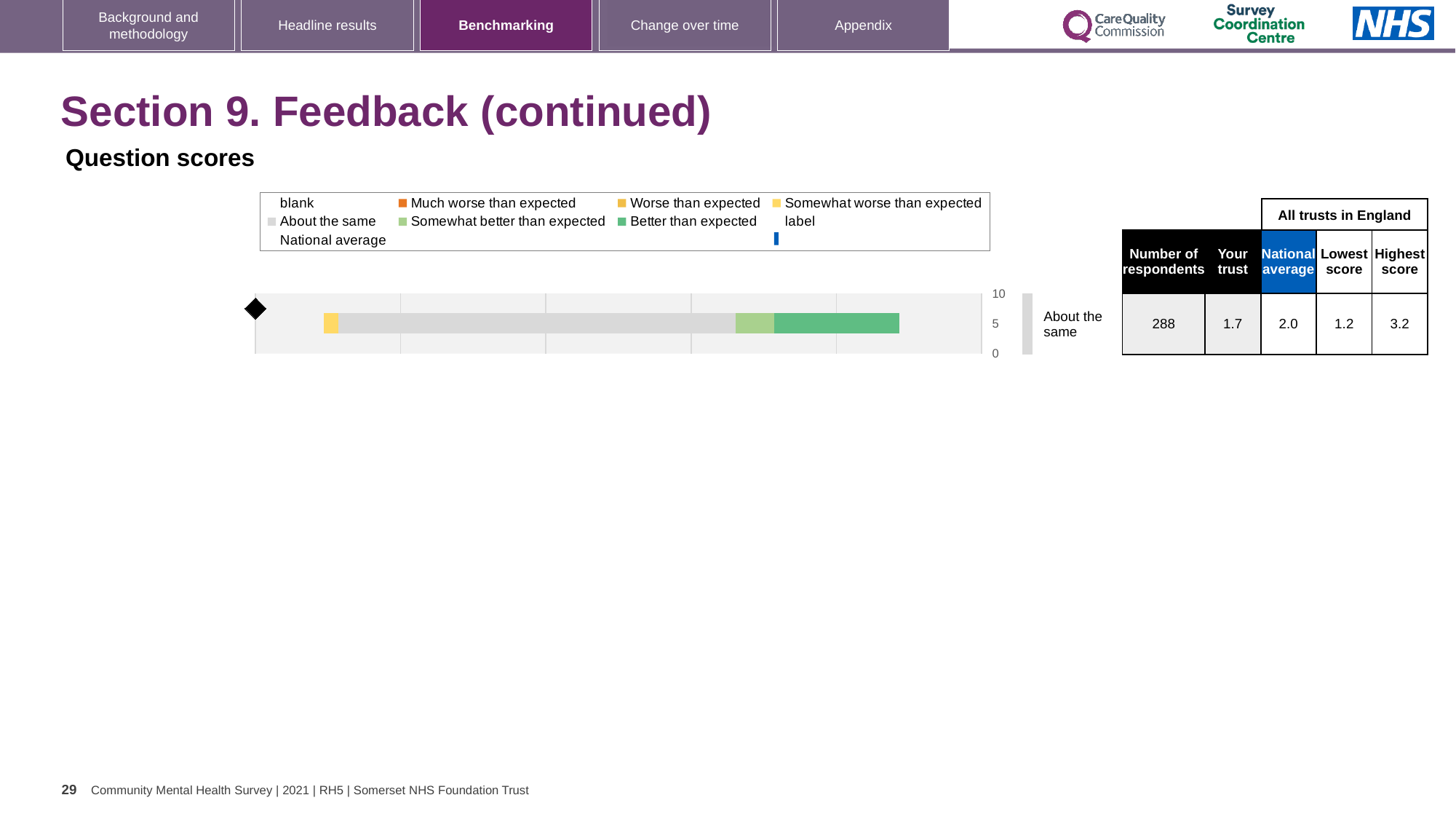
In the table beside the chart, what is the 'Your trust' score for 'About the same'? 1.7 Which is larger, the 'Your trust' score or the National average score? National average What is the label of the single category plotted in the chart? About the same Which segment of the stacked bar is the widest? About the same Which visible segment of the stacked bar is the narrowest? Somewhat worse than expected How many question categories are plotted in the chart? 1 What kind of chart is shown on the slide? bar chart What is the difference between the Highest score and the Lowest score in the table? 2.0 Which legend entry is shown in dark green? Better than expected In the table beside the chart, what is the Highest score among all trusts in England? 3.2 In the table beside the chart, what is the National average score? 2.0 In the table beside the chart, how many respondents are listed? 288